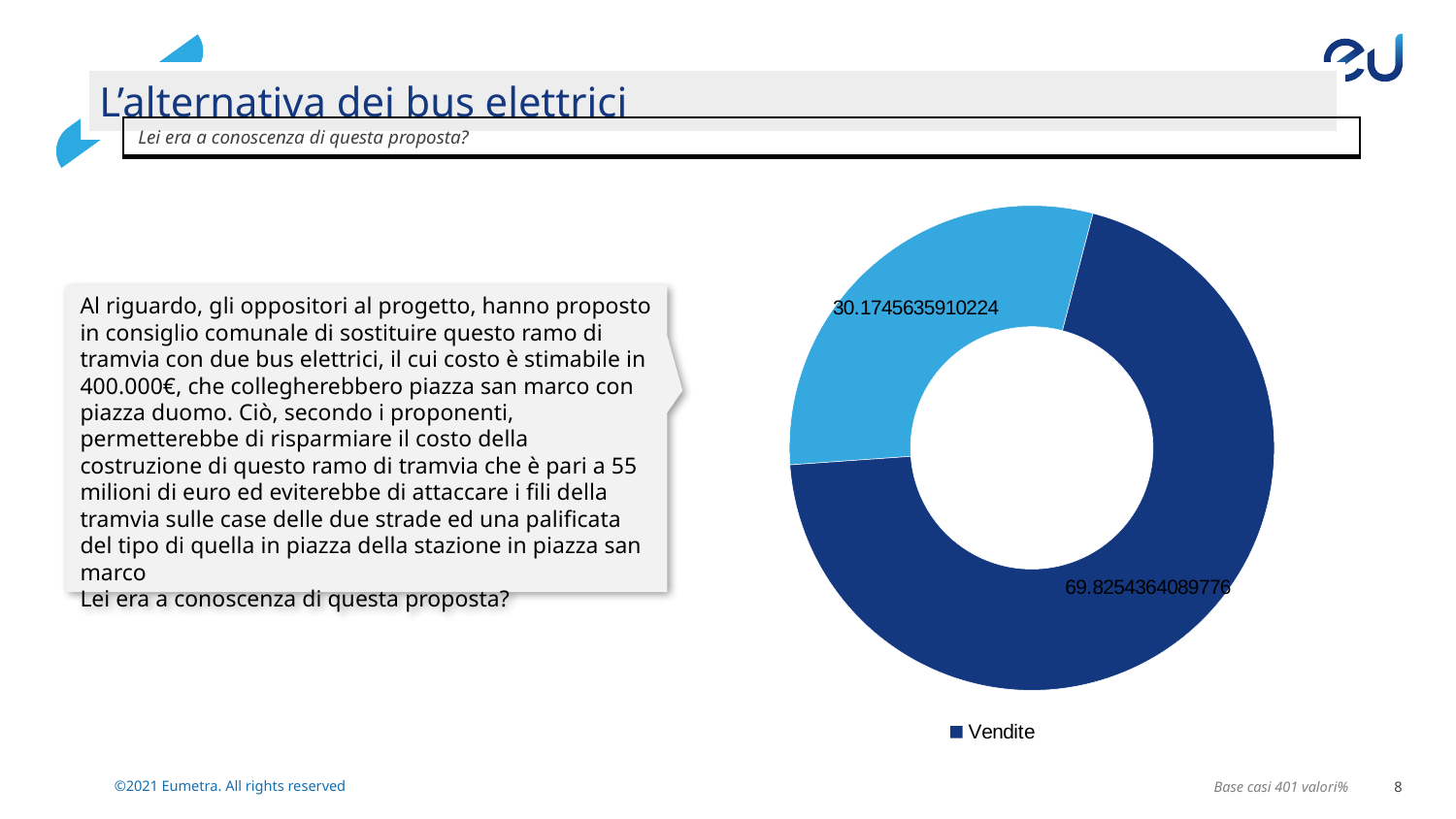
Is the value of the light blue slice larger or smaller than the value of the dark blue slice? Smaller What colour is the larger slice of the doughnut chart? Dark blue What value is printed on the dark blue slice of the doughnut chart? 69.8254364089776 What is the difference between the two values printed on the doughnut chart? 39.6508728179552 How many slices does the doughnut chart have? 2 What kind of chart is shown on the slide? Doughnut (pie) chart Which slice of the doughnut chart is the smallest, the dark blue one or the light blue one? The light blue one What is the total of the two values printed on the doughnut chart? 100 How many series does the legend of the chart list? 1 Which slice of the doughnut chart is the largest, the dark blue one or the light blue one? The dark blue one What is the legend entry shown below the chart? Vendite What value is printed on the light blue slice of the doughnut chart? 30.1745635910224